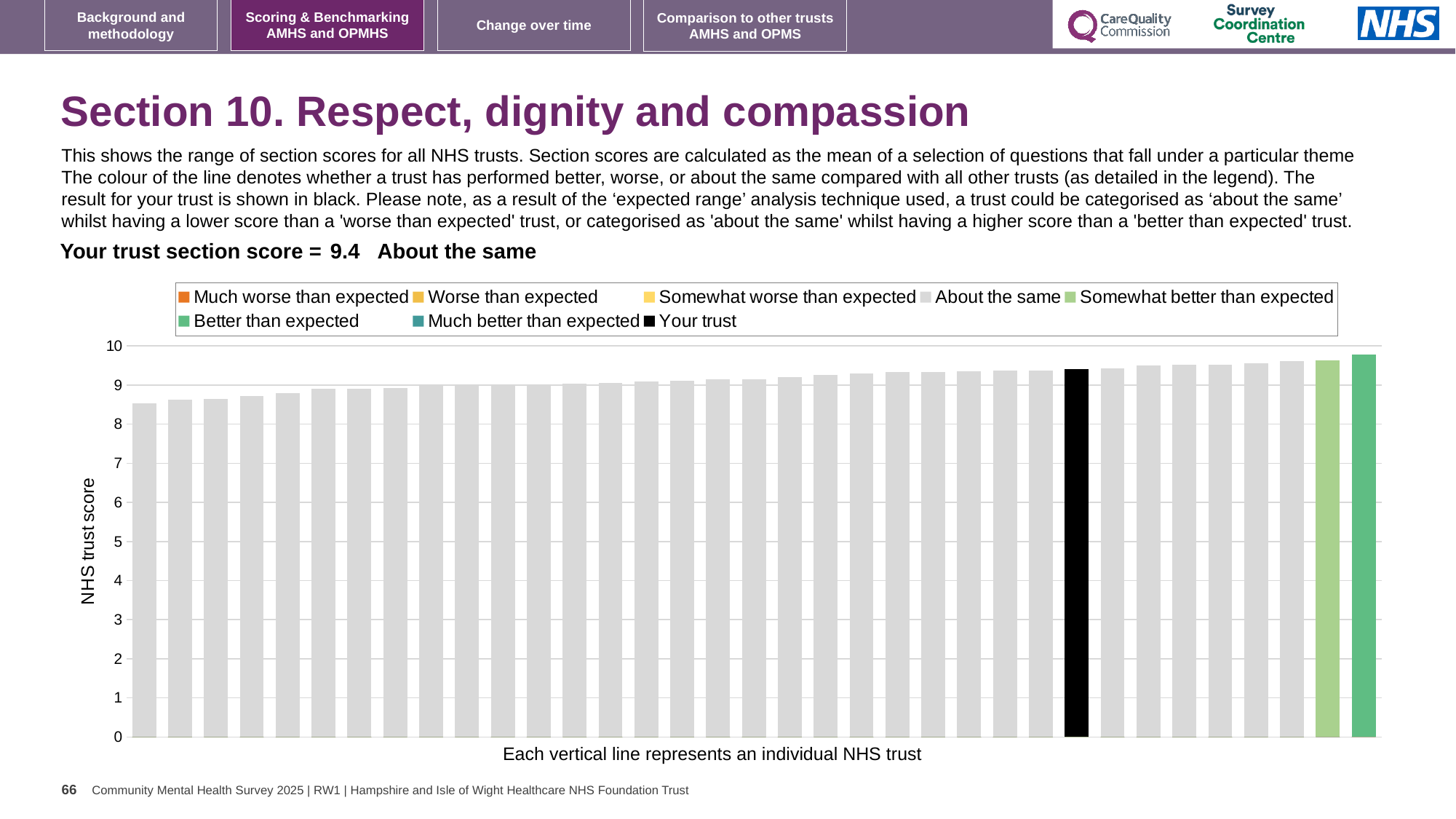
How many entries does the chart legend list? 8 Is the value of the rightmost bar greater or less than 9? greater Is the value of the leftmost bar greater or less than 8? greater Which benchmarking category is your trust placed in for Section 10? About the same Which bar has the highest value: the leftmost bar or the rightmost bar? The rightmost bar Which colour is used for the bar representing your trust? Black Is the value of the black bar (your trust) greater or less than 9? greater What is the label on the vertical axis of the chart? NHS trust score Do the bar values rise or fall from left to right across the chart? Rise What is the section score for your trust shown on the slide? 9.4 What kind of chart is shown on the slide? Bar chart